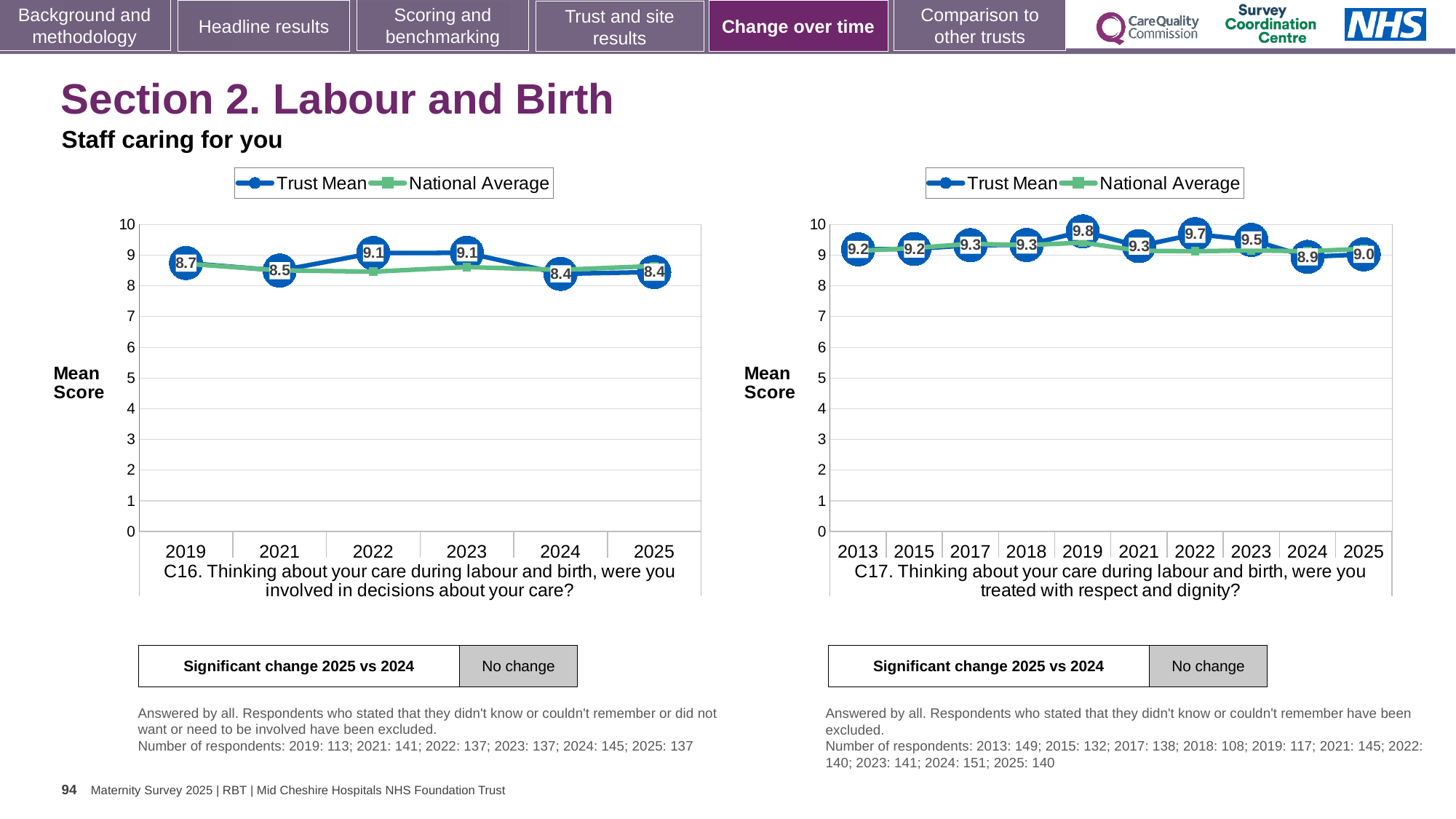
In the C17 chart on the right, what is the Trust Mean for 2025? 9.0 In the C16 chart on the left, what is the Trust Mean for 2019? 8.7 In the C17 chart on the right, what is the Trust Mean for 2019? 9.8 What kind of chart is the C16 chart on the left? Line chart How many years are plotted on the x axis of the C17 chart on the right? 10 How many series does the legend of the C16 chart on the left list? 2 In the C16 chart on the left, what is the Trust Mean for 2022? 9.1 In the C16 chart on the left, is the National Average for 2019 greater or less than 8? greater In the C17 chart on the right, which year has the highest Trust Mean? 2019 In the C17 chart on the right, which is larger, the Trust Mean for 2022 or the Trust Mean for 2024? 2022 In the C17 chart on the right, which year has the lowest Trust Mean? 2024 In the C16 chart on the left, what is the difference between the Trust Mean for 2023 and the Trust Mean for 2024? 0.7